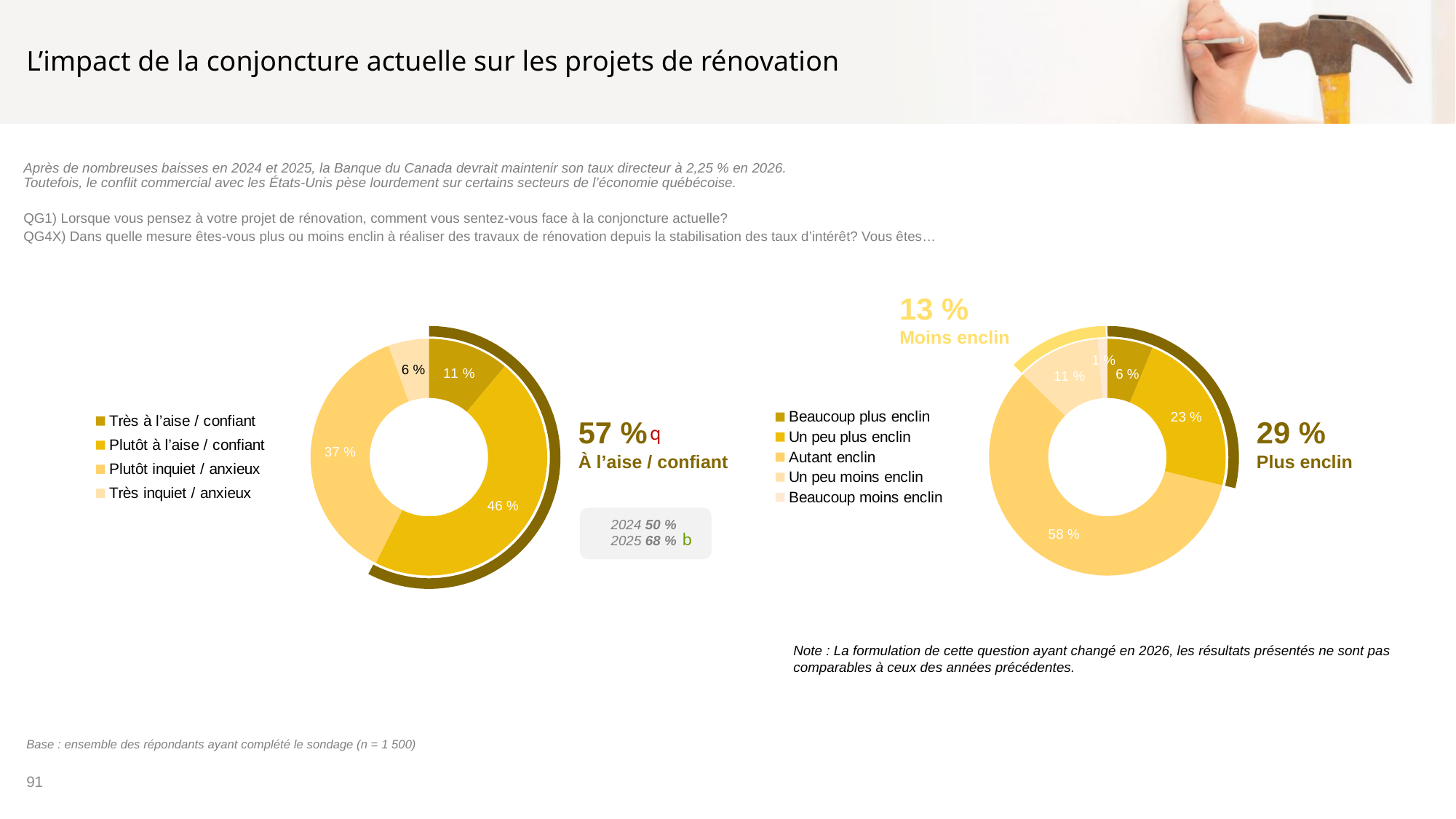
In the left chart (QG1), how many categories does the legend list? 4 In the right chart (QG4X), which is larger: "Un peu moins enclin" or "Beaucoup plus enclin"? Un peu moins enclin In the right chart (QG4X), what percentage of respondents are "Autant enclin"? 58 % In the left chart (QG1), what is the difference between "Plutôt à l'aise / confiant" and "Plutôt inquiet / anxieux"? 9 % In the right chart (QG4X), which category has the smallest share? Beaucoup moins enclin What kind of chart is used on the left side of the slide (QG1)? Donut chart In the right chart (QG4X), what percentage of respondents are "Un peu plus enclin"? 23 % What total percentage is shown next to the right chart (QG4X) for "Plus enclin"? 29 % In the left chart (QG1), which category has the largest share? Plutôt à l'aise / confiant In the left chart (QG1), what percentage of respondents are "Plutôt à l'aise / confiant"? 46 % In the left chart (QG1), what percentage of respondents are "Très inquiet / anxieux"? 6 % In the right chart (QG4X), how many categories does the legend list? 5